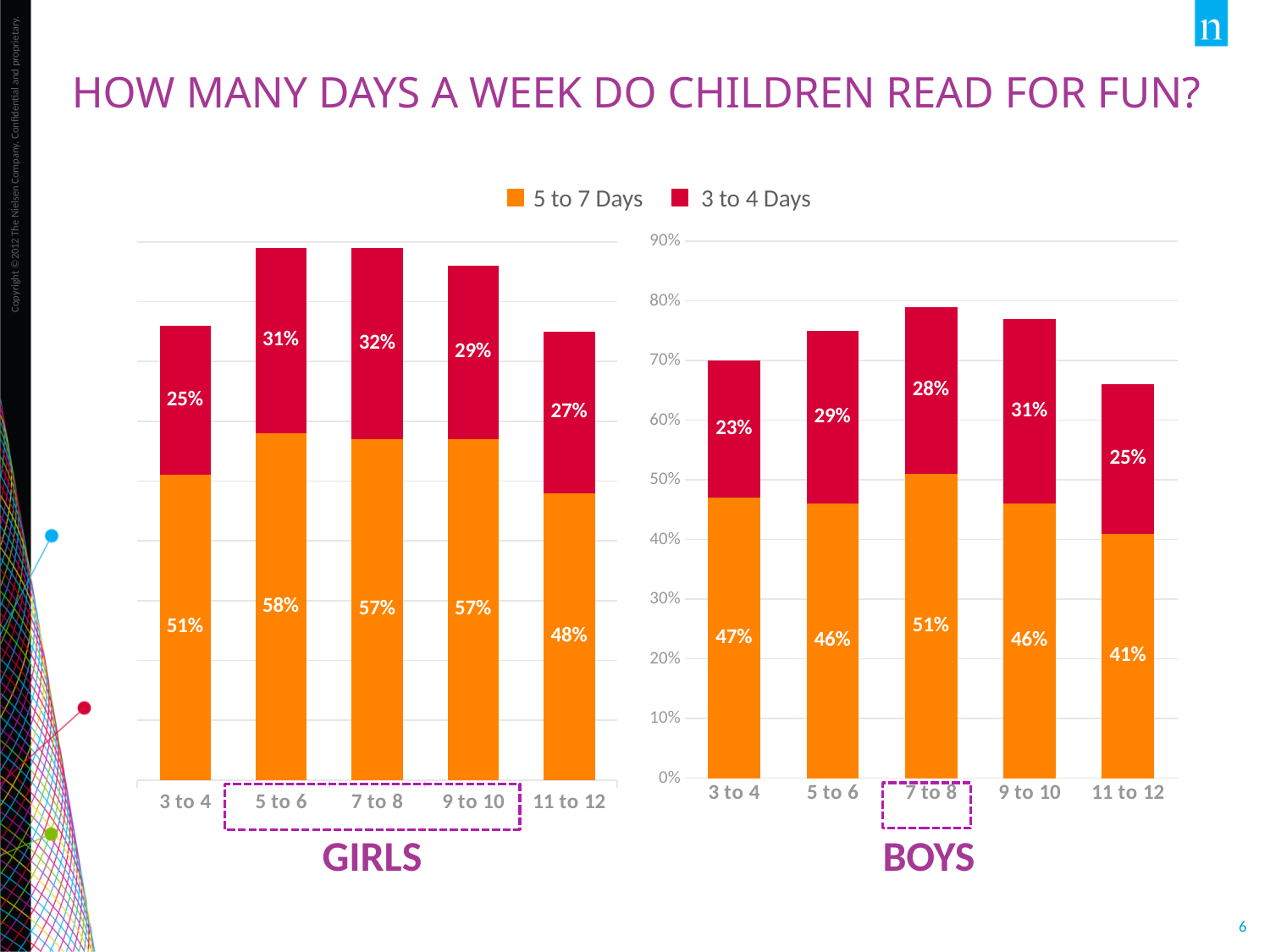
In the GIRLS chart, which age group has the lowest value for 5 to 7 Days? 11 to 12 In the BOYS chart, which is larger: the 3 to 4 Days value for 9 to 10 or for 3 to 4? 9 to 10 In the GIRLS chart, what percentage of girls aged 5 to 6 read for fun 5 to 7 days a week? 58% How many series does the legend list? 2 In the BOYS chart, what percentage of boys aged 11 to 12 read for fun 3 to 4 days a week? 25% In the BOYS chart, which age group has the highest value for 5 to 7 Days? 7 to 8 In the GIRLS chart, what is the total of the stacked bar for the 11 to 12 age group? 75% In the BOYS chart, what is the total of the stacked bar for the 3 to 4 age group? 70% What kind of chart is the GIRLS chart? Stacked bar chart In the GIRLS chart, what is the difference between the 5 to 7 Days values for the 5 to 6 and 11 to 12 age groups? 10% How many age groups are shown in the BOYS chart? 5 Which colour represents the 3 to 4 Days series in the legend? Red